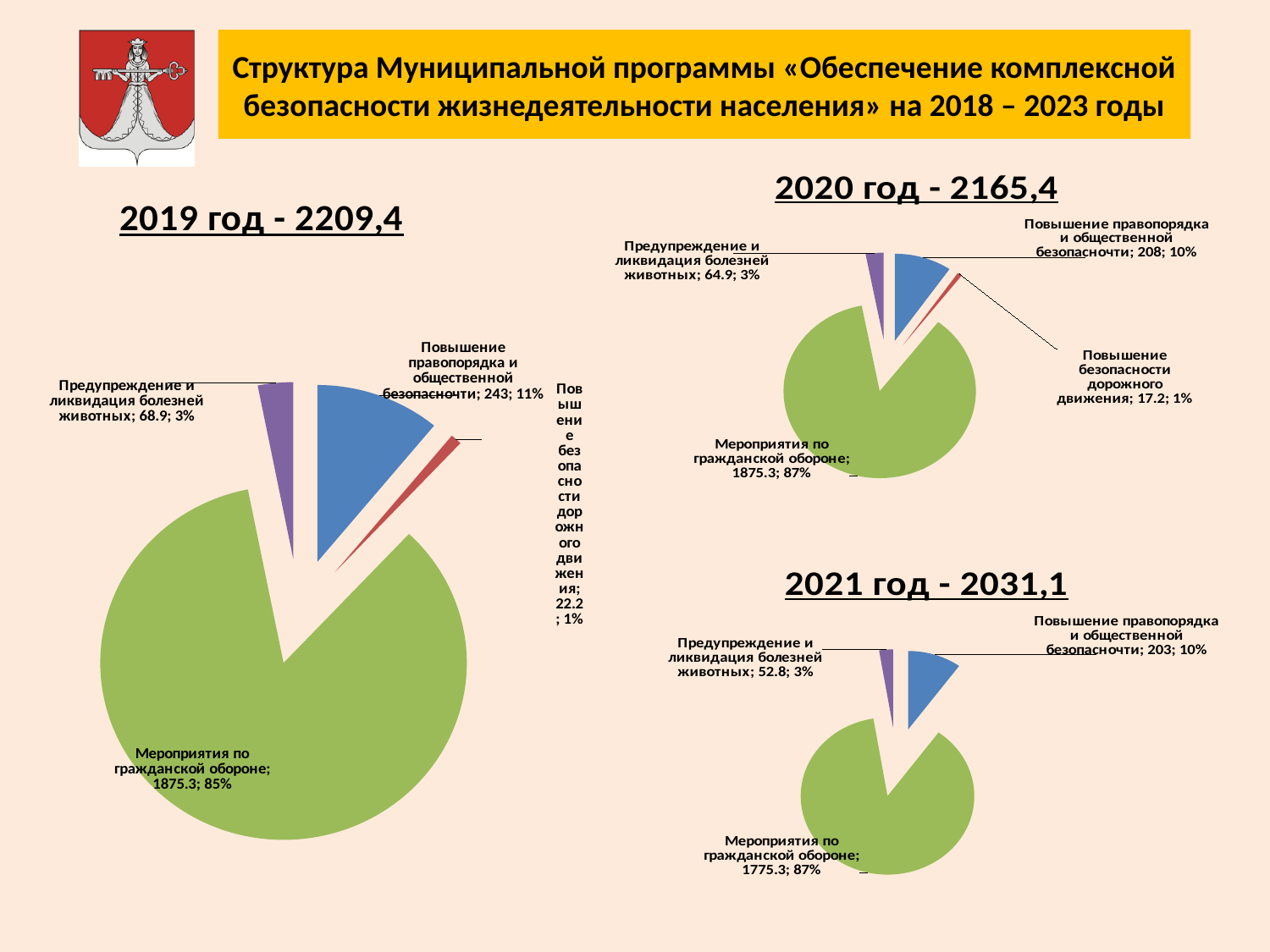
In the 2019 год pie chart, which category has the smallest slice? Повышение безопасности дорожного движения In the 2021 год pie chart, what is the value for Повышение правопорядка и общественной безопасночти? 203; 10% What is the difference between the Повышение правопорядка и общественной безопасночти values in the 2019 год and 2020 год pie charts? 35 In the 2019 год pie chart, what is the value for Мероприятия по гражданской обороне? 1875.3; 85% Which is larger: Предупреждение и ликвидация болезней животных in the 2019 год chart or in the 2021 год chart? 2019 год In the 2020 год pie chart, which category has the largest slice? Мероприятия по гражданской обороне In the 2021 год pie chart, what is the value for Мероприятия по гражданской обороне? 1775.3; 87% In the 2020 год pie chart, what is the value for Предупреждение и ликвидация болезней животных? 64.9; 3% In the 2020 год pie chart, what is the value for Повышение безопасности дорожного движения? 17.2; 1% In the 2019 год pie chart, what share does Повышение правопорядка и общественной безопасночти have? 11% What type of chart is used for the 2021 год data? Pie chart In the 2019 год pie chart, how many slices are there? 4